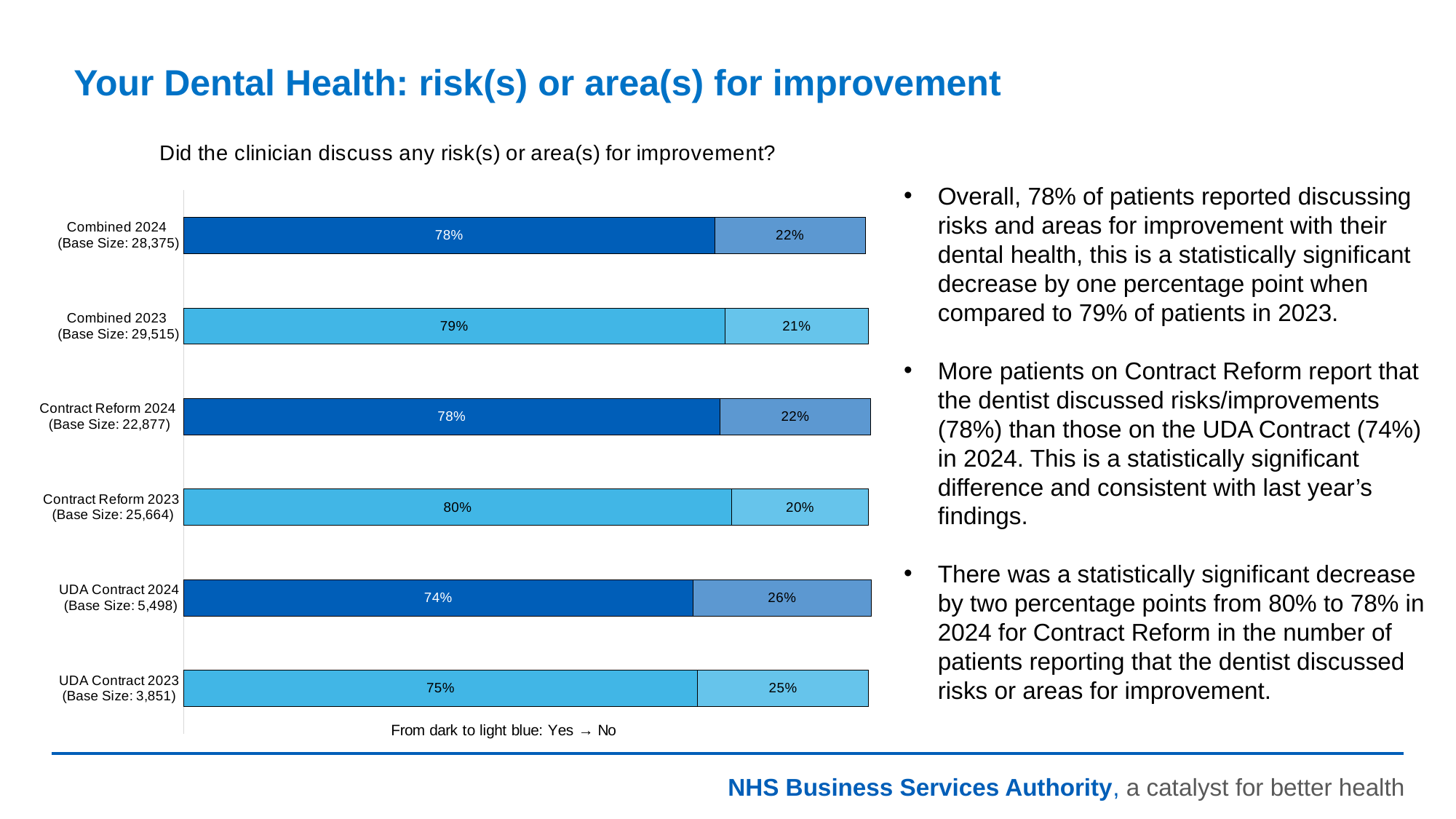
What percentage of UDA Contract 2024 patients answered No? 26% What type of chart is shown on the slide? Stacked bar chart How many categories (bars) are shown in the chart? 6 What percentage of Combined 2024 patients answered Yes? 78% What is the total of the Yes and No segments for the Combined 2023 bar? 100% What is the base size for Contract Reform 2024? 22,877 Which category has the lowest Yes percentage? UDA Contract 2024 Which category has the highest Yes percentage? Contract Reform 2023 What is the difference in Yes percentage between Contract Reform 2024 and UDA Contract 2024? 4 percentage points According to the note below the chart, what do the dark and light blue segments represent? Dark blue: Yes, light blue: No Which has a larger No percentage, UDA Contract 2023 or Combined 2023? UDA Contract 2023 What is the Yes percentage for Contract Reform 2023? 80%